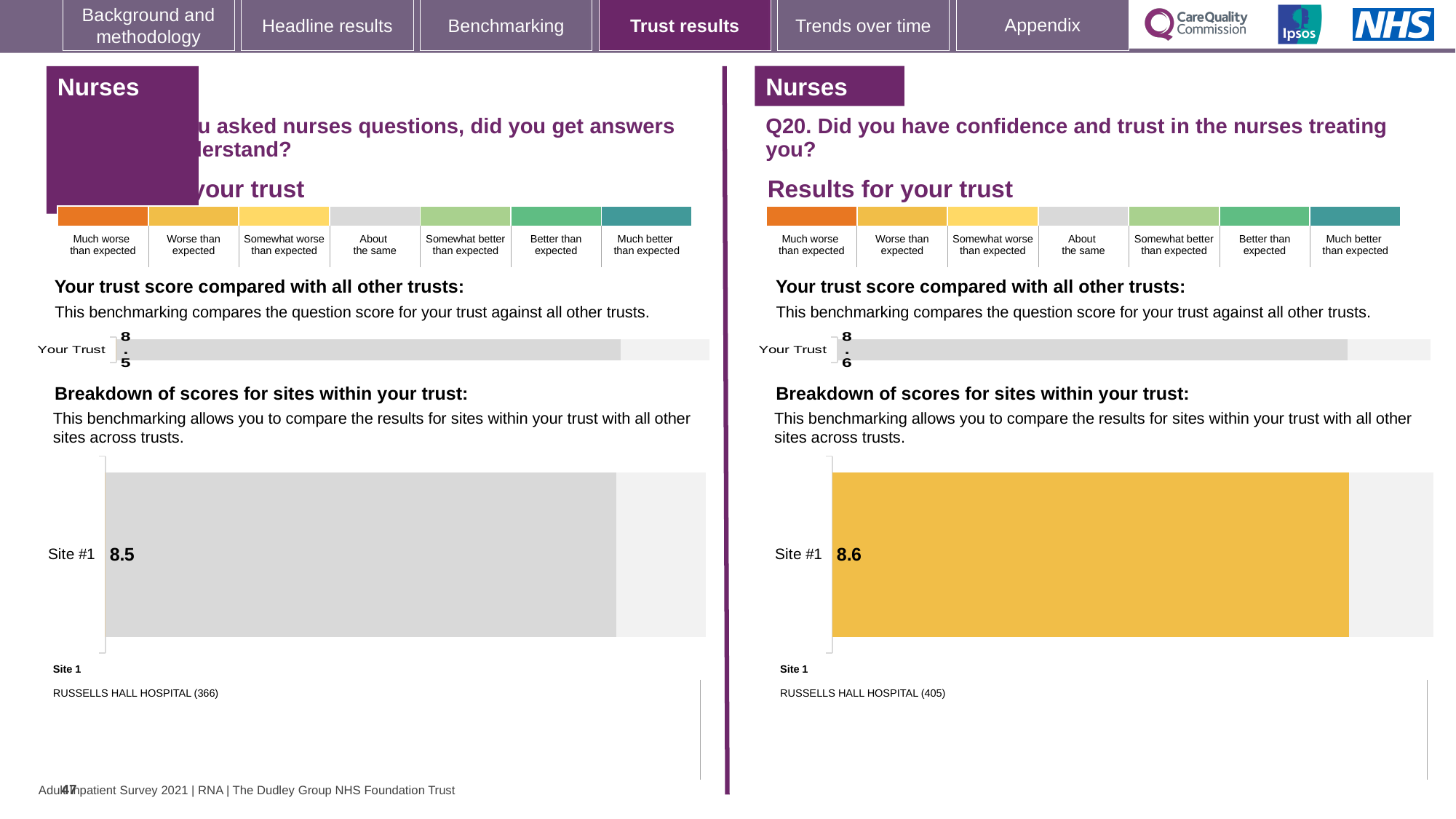
On the left-hand chart (nurses questions, answers you could understand), what is the score shown for Your Trust? 8.5 What colour is the Site #1 bar in the right-hand Q20 breakdown chart? Yellow Which Site #1 score is higher: the one in the left-hand breakdown chart or the one in the right-hand Q20 breakdown chart? The right-hand Q20 chart (8.6) On the right-hand chart for Q20 (confidence and trust in nurses), what is the score shown for Your Trust? 8.6 How many sites are shown in the left-hand breakdown of scores for sites chart? 1 In the right-hand breakdown of scores for sites chart (Q20), what is the score for Site #1? 8.6 How many sites are shown in the right-hand breakdown of scores for sites chart (Q20)? 1 What type of chart is used for the breakdown of scores for sites within your trust on the right-hand side (Q20)? Bar chart What is the difference between the Site #1 score in the right-hand Q20 breakdown chart and the Site #1 score in the left-hand breakdown chart? 0.1 Which hospital is listed as Site 1 beneath the right-hand Q20 breakdown chart? RUSSELLS HALL HOSPITAL (405) In the left-hand breakdown of scores for sites chart, what is the score for Site #1? 8.5 Is the Your Trust score in the right-hand Q20 chart greater or less than 8? greater